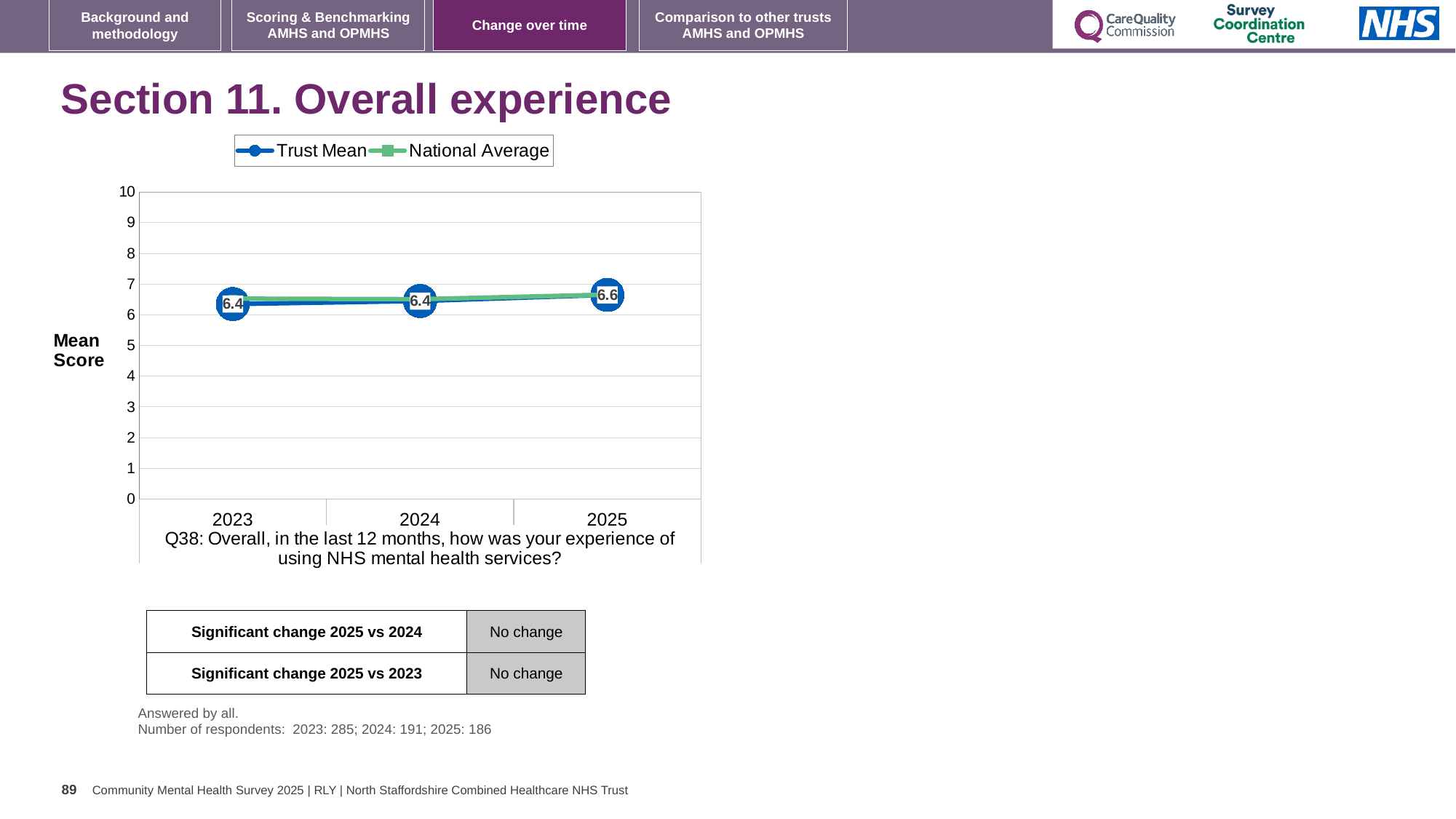
How many years are plotted on the x axis? 3 What kind of chart is shown on the slide? line chart How many series does the legend list? 2 In which year is the Trust Mean highest? 2025 Does the Trust Mean rise or fall from 2023 to 2025? rise What is the label on the y axis of the chart? Mean Score What is the Trust Mean value for 2025? 6.6 What is the difference between the Trust Mean in 2025 and in 2023? 0.2 What is the Trust Mean value for 2024? 6.4 Which is larger, the Trust Mean for 2025 or the Trust Mean for 2024? 2025 Is the Trust Mean value for 2024 greater or less than 5? greater What is the Trust Mean value for 2023? 6.4